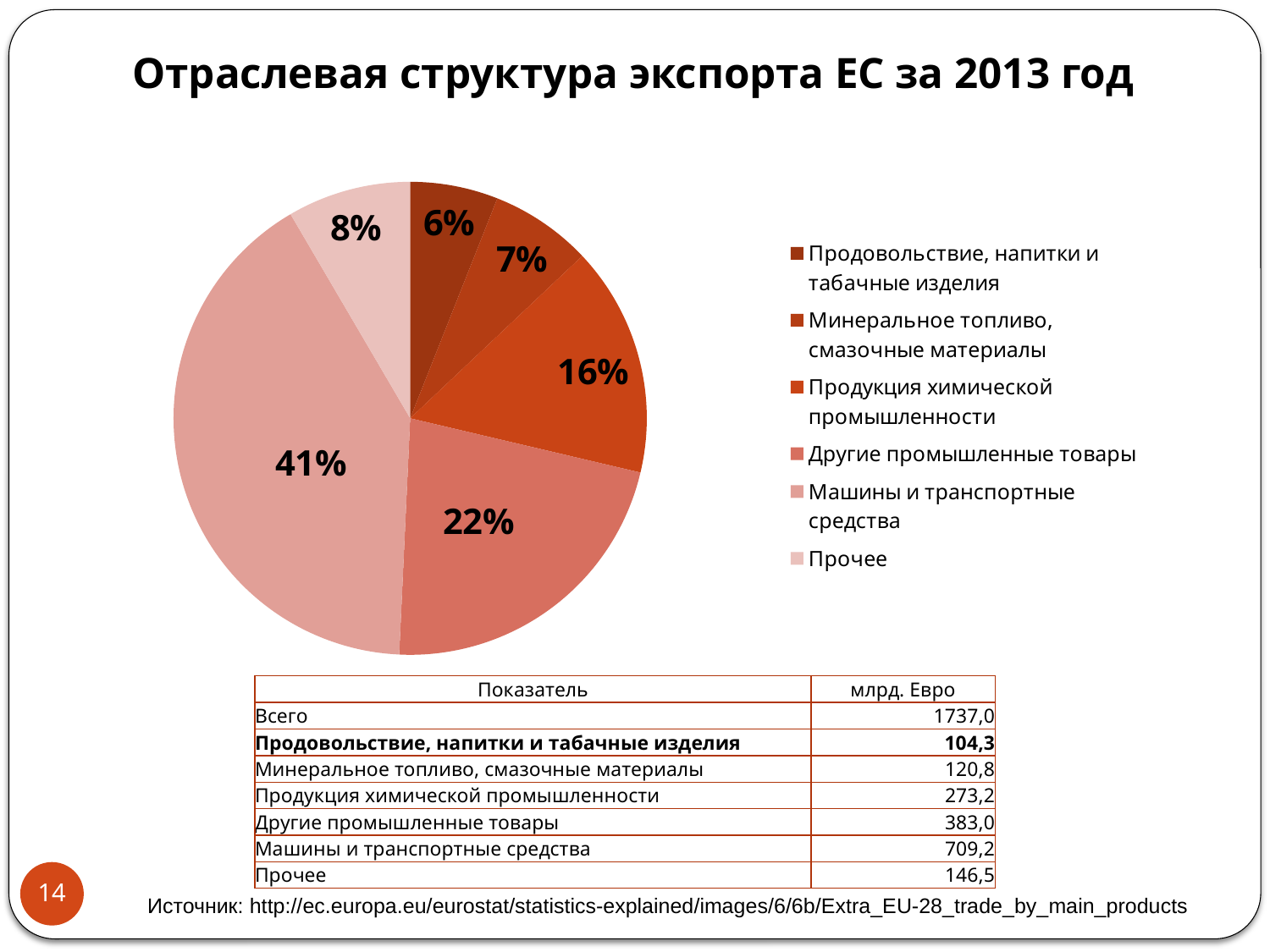
Which category has the smallest slice of the pie? Продовольствие, напитки и табачные изделия What share of the pie does "Прочее" have? 8% What share of the pie does "Продовольствие, напитки и табачные изделия" have? 6% How many slices does the pie chart have? 6 Which category has the largest slice of the pie? Машины и транспортные средства What kind of chart is shown on the slide? pie chart What is the difference in percentage points between "Другие промышленные товары" and "Минеральное топливо, смазочные материалы"? 15 What is the title of the slide containing the pie chart? Отраслевая структура экспорта ЕС за 2013 год How many entries does the legend list? 6 What share of the pie does "Продукция химической промышленности" have? 16% Which is larger: the share for "Прочее" or the share for "Минеральное топливо, смазочные материалы"? Прочее